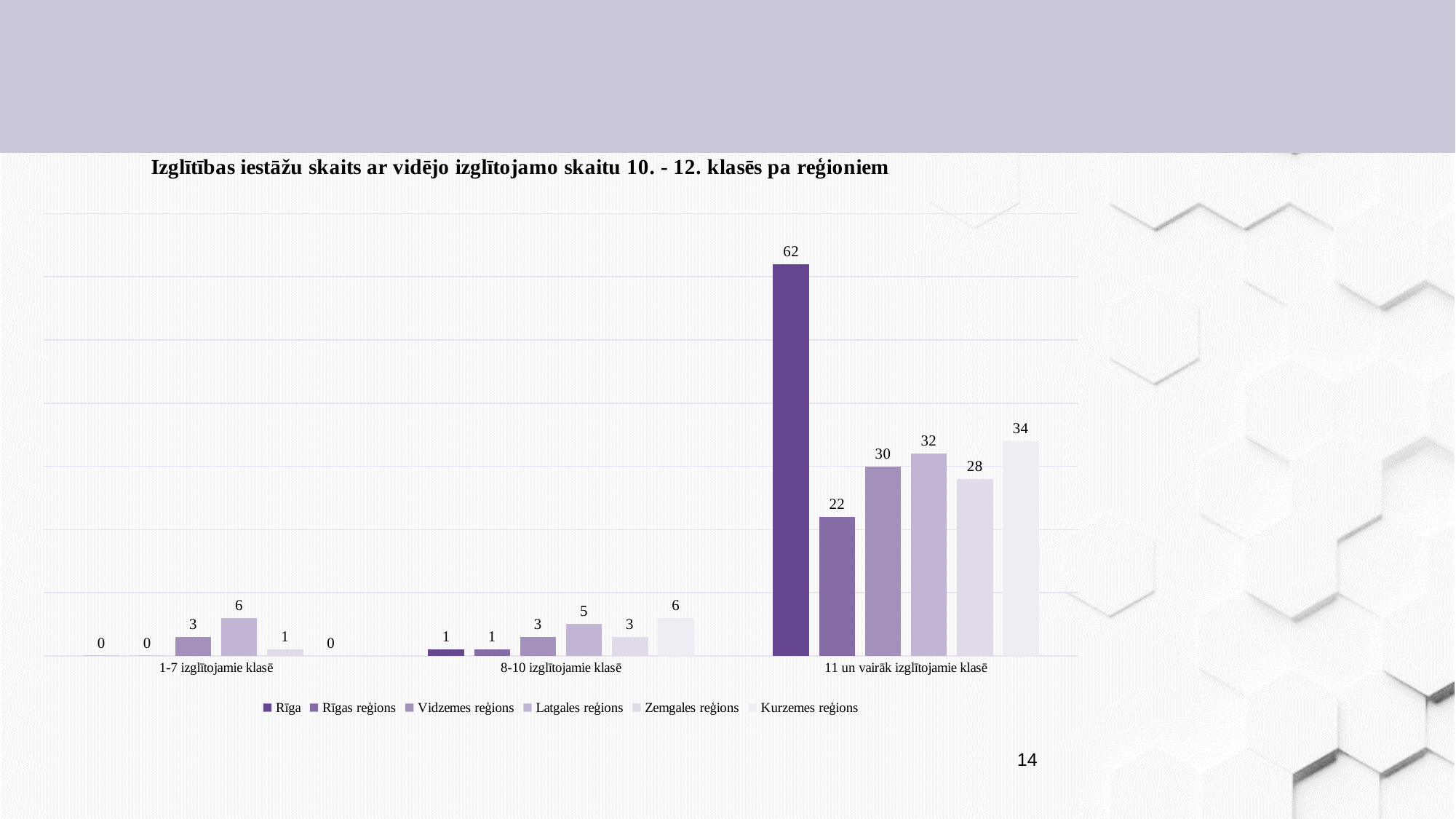
What is the value for Latgales reģions in the "1-7 izglītojamie klasē" category? 6 How many categories are shown on the x axis? 3 Which region has the highest value in the "11 un vairāk izglītojamie klasē" category? Rīga What is the difference between Rīga and Rīgas reģions in the "11 un vairāk izglītojamie klasē" category? 40 In the "11 un vairāk izglītojamie klasē" category, which is larger: Vidzemes reģions or Kurzemes reģions? Kurzemes reģions What kind of chart is shown on the slide? Bar chart How many series does the legend list? 6 Which region has the lowest value in the "11 un vairāk izglītojamie klasē" category? Rīgas reģions What is the value for Rīga in the "11 un vairāk izglītojamie klasē" category? 62 What is the value for Zemgales reģions in the "11 un vairāk izglītojamie klasē" category? 28 What is the value for Kurzemes reģions in the "8-10 izglītojamie klasē" category? 6 What is the title of the chart? Izglītības iestāžu skaits ar vidējo izglītojamo skaitu 10. - 12. klasēs pa reģioniem